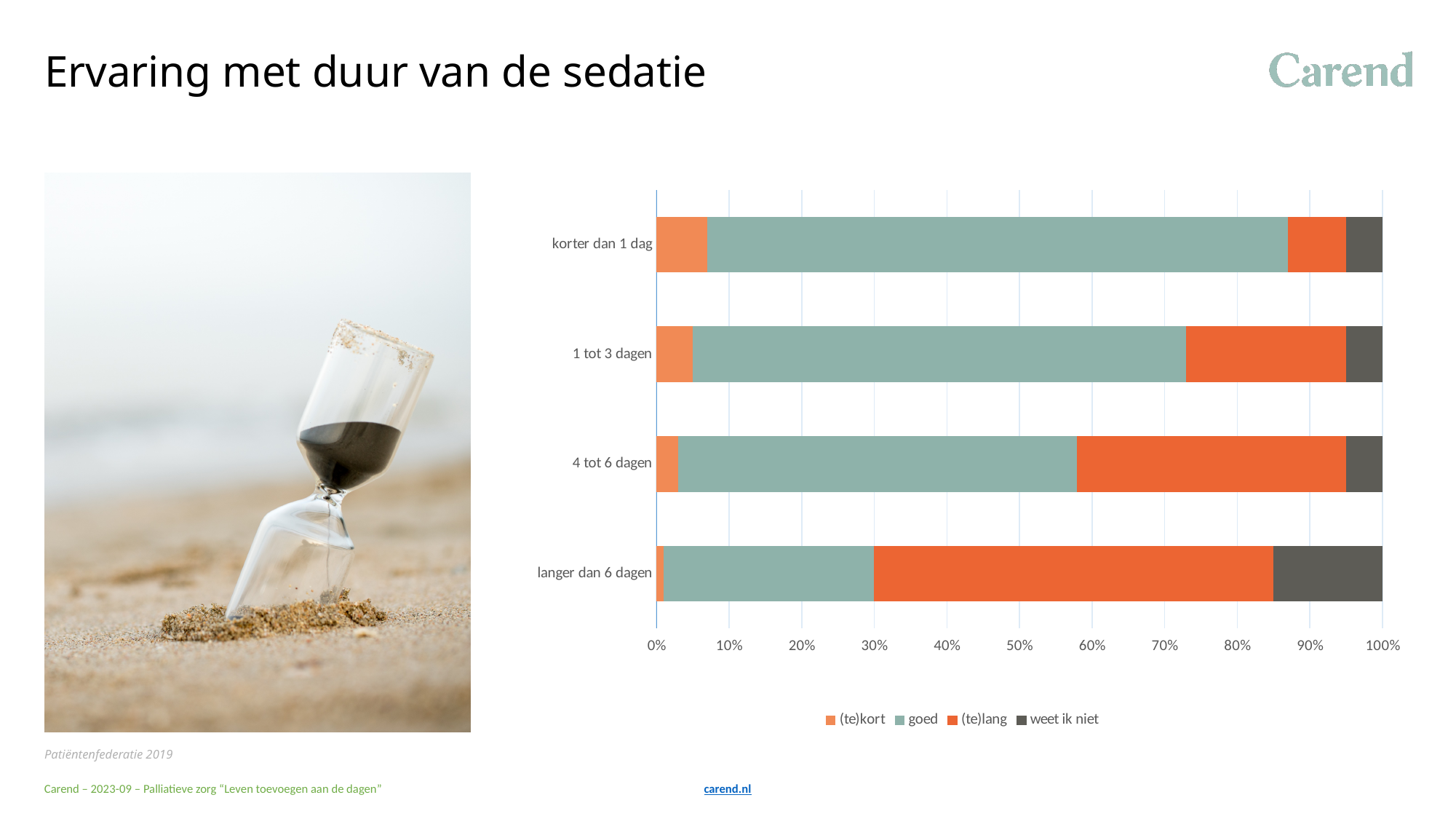
How many categories (sedation durations) are shown on the chart? 4 Is the 'goed' share for 'korter dan 1 dag' greater or less than 70%? greater Which category has the largest '(te)lang' share? langer dan 6 dagen Which category has the smallest 'goed' share? langer dan 6 dagen Which category has the largest 'goed' share? korter dan 1 dag Which category has the largest 'weet ik niet' share? langer dan 6 dagen Is the '(te)lang' share for 'langer dan 6 dagen' greater or less than 50%? greater Which has a larger 'goed' share: '1 tot 3 dagen' or '4 tot 6 dagen'? 1 tot 3 dagen As the sedation duration increases from 'korter dan 1 dag' to 'langer dan 6 dagen', does the 'goed' share rise or fall? fall What kind of chart is shown on the slide? stacked bar chart How many series does the legend list? 4 Is the '(te)kort' share for 'korter dan 1 dag' greater or less than 10%? less